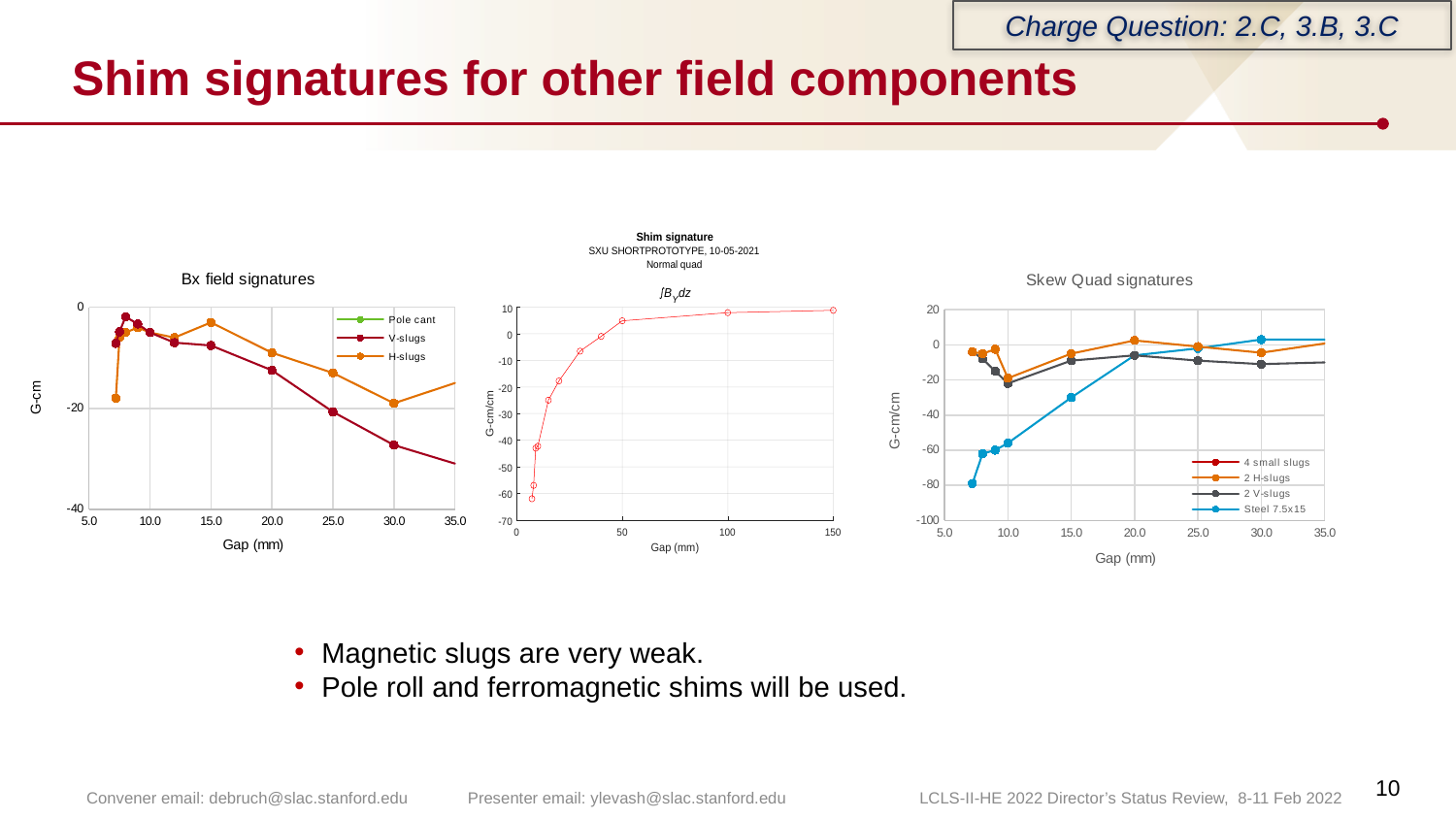
In the "Bx field signatures" chart, is the V-slugs value at a gap of 30.0 mm greater or less than -20? less In the middle "Shim signature" chart, is the value at a gap of 150 mm greater or less than 0? greater In the middle "Shim signature" chart, do the values rise or fall as the gap increases? rise In the "Bx field signatures" chart, do the V-slugs values rise or fall as the gap increases from 10.0 to 35.0 mm? fall How many series does the legend of the "Bx field signatures" chart list? 3 What is the y-axis label of the "Bx field signatures" chart? G-cm In the "Skew Quad signatures" chart, which series reaches the lowest value? Steel 7.5x15 How many series does the legend of the "Skew Quad signatures" chart list? 4 In the "Skew Quad signatures" chart, at a gap of 10.0 mm, which is larger: the 2 H-slugs value or the Steel 7.5x15 value? 2 H-slugs In the "Skew Quad signatures" chart, is the Steel 7.5x15 value at the smallest gap greater or less than -60? less In the "Skew Quad signatures" chart, do the Steel 7.5x15 values rise or fall as the gap increases? rise What kind of chart is the "Bx field signatures" chart? line chart